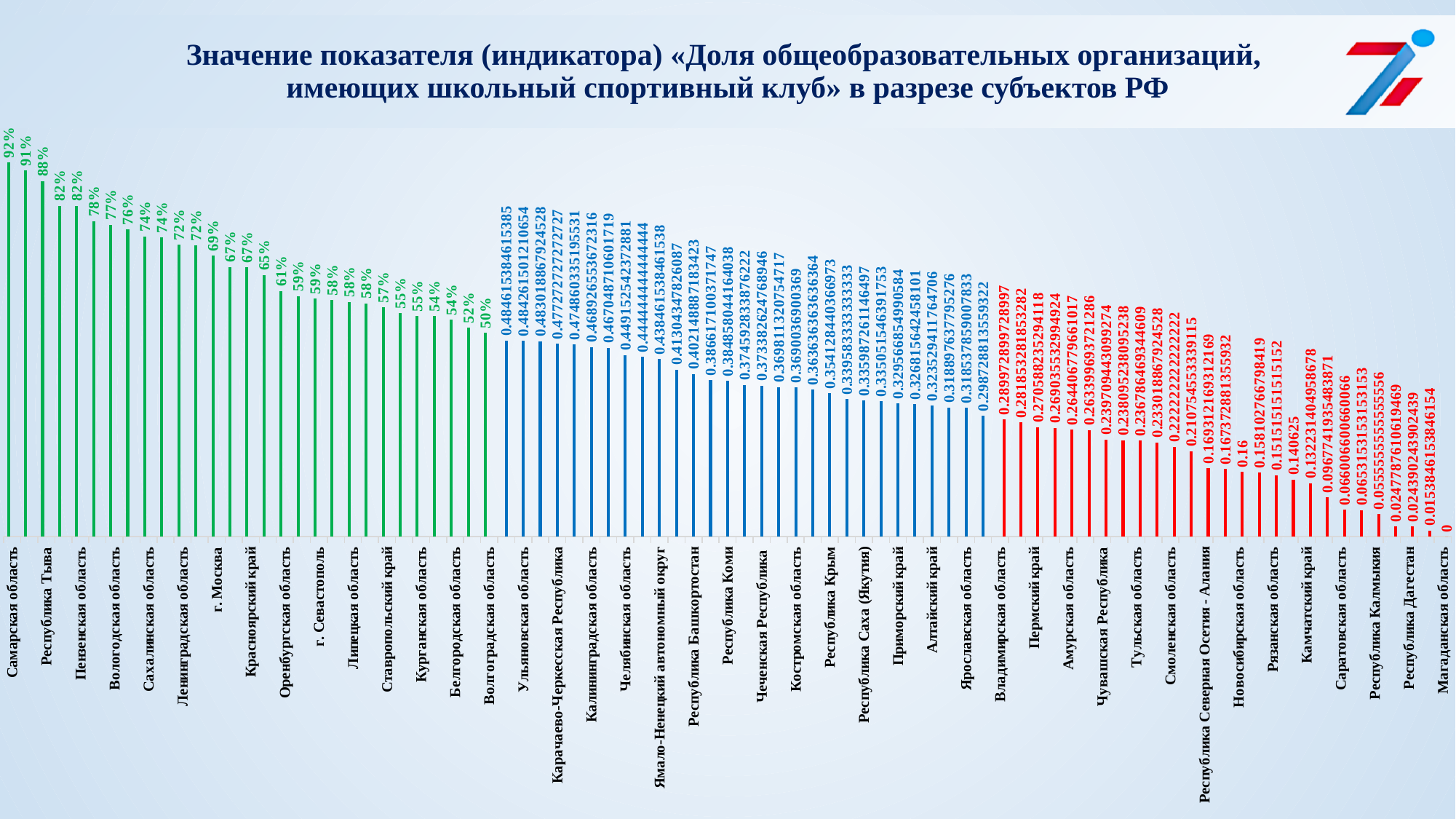
Which region has the highest value in the chart? Самарская область What is the value shown for Республика Тыва? 88% Do the values rise or fall moving from left to right along the x axis? fall What is the value shown for Волгоградская область? 50% What is the value shown for Новосибирская область? 0.16 Which has a larger value, Самарская область or Магаданская область? Самарская область What is the value shown for Магаданская область? 0 What type of chart is shown on the slide? bar chart What is the value shown for г. Москва? 69% Which region has the lowest value in the chart? Магаданская область What colour are the bars for the regions with the lowest values on the right side of the chart? red What is the value shown for Самарская область? 92%